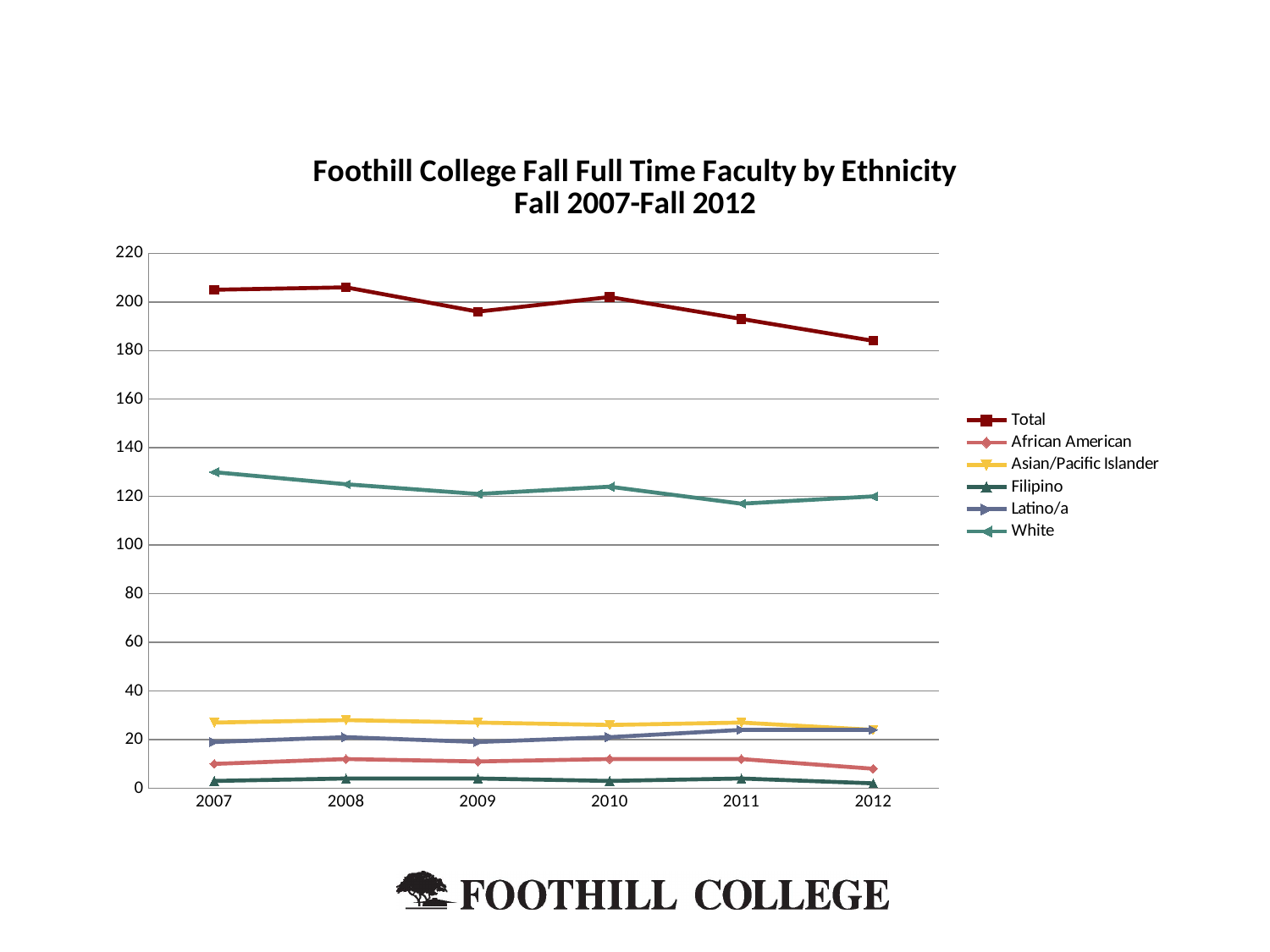
Is the value for Asian/Pacific Islander in 2008 greater or less than 20? greater In 2010, which is larger: Latino/a or African American? Latino/a What is the title of the chart? Foothill College Fall Full Time Faculty by Ethnicity Fall 2007-Fall 2012 How many years are plotted along the x axis? 6 In which year is the Total series at its lowest? 2012 How many series does the legend list? 6 What kind of chart is shown on the slide? line chart Is the value for Total in 2007 greater or less than 200? greater Is the value for White in 2007 greater or less than 120? greater In which year is the White series at its highest? 2007 Which series has the lowest values across all years? Filipino